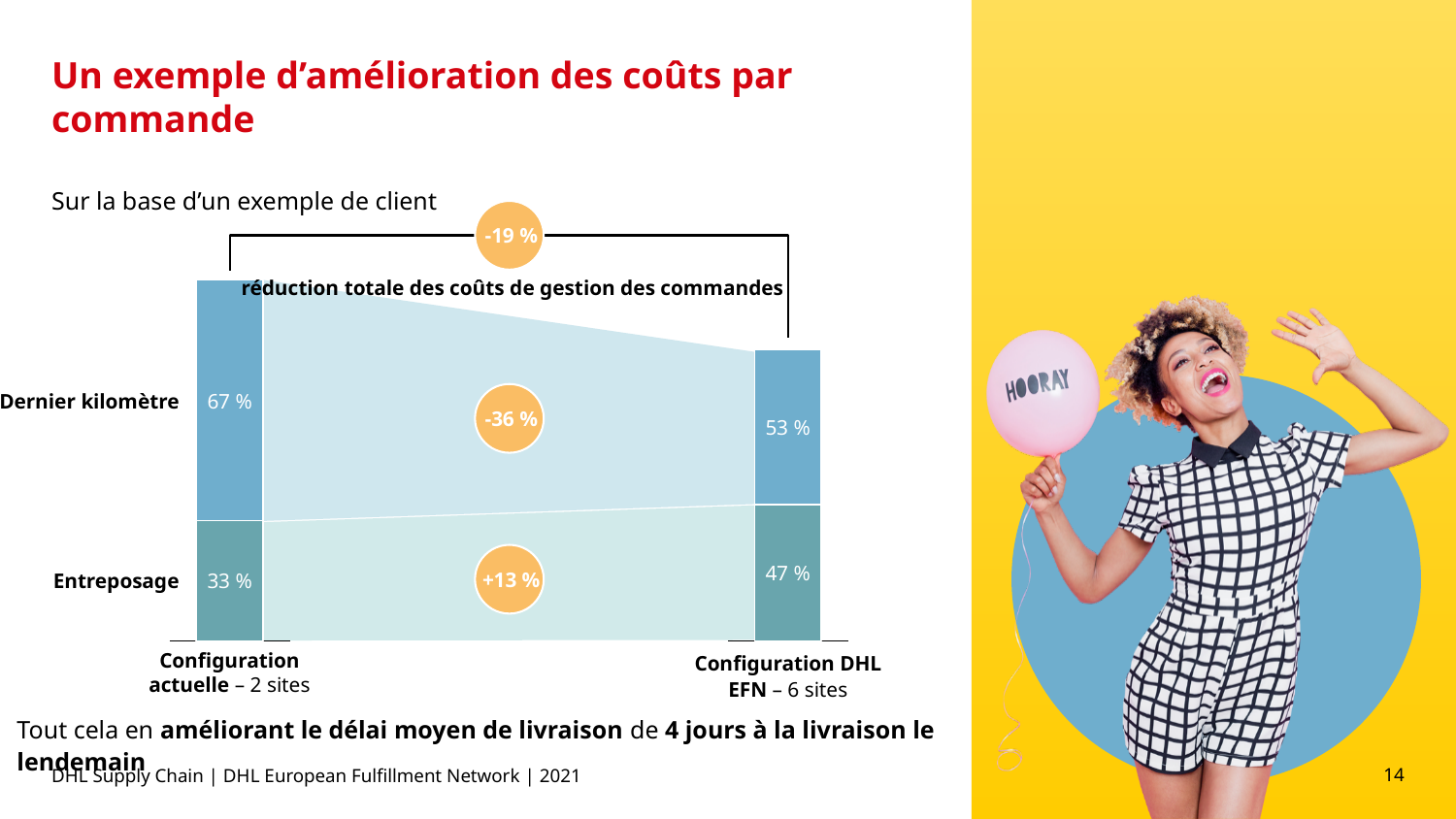
What is the value for Dernier kilomètre in the Configuration DHL EFN – 6 sites bar? 53 % What is the value for Dernier kilomètre in the Configuration actuelle – 2 sites bar? 67 % What is the total of the Configuration actuelle – 2 sites stacked bar? 100 % What is the value for Entreposage in the Configuration actuelle – 2 sites bar? 33 % Which configuration has the larger Dernier kilomètre share, Configuration actuelle or Configuration DHL EFN? Configuration actuelle How many configurations (bars) are shown in the chart? 2 What is the value for Entreposage in the Configuration DHL EFN – 6 sites bar? 47 % What is the difference between the Entreposage values of Configuration DHL EFN and Configuration actuelle? 14 % What percentage change is shown for Dernier kilomètre between the two configurations? -36 % What kind of chart is shown on the slide? Stacked bar chart What is the total reduction in order management costs shown at the top of the chart? -19 % What percentage change is shown for Entreposage between the two configurations? +13 %